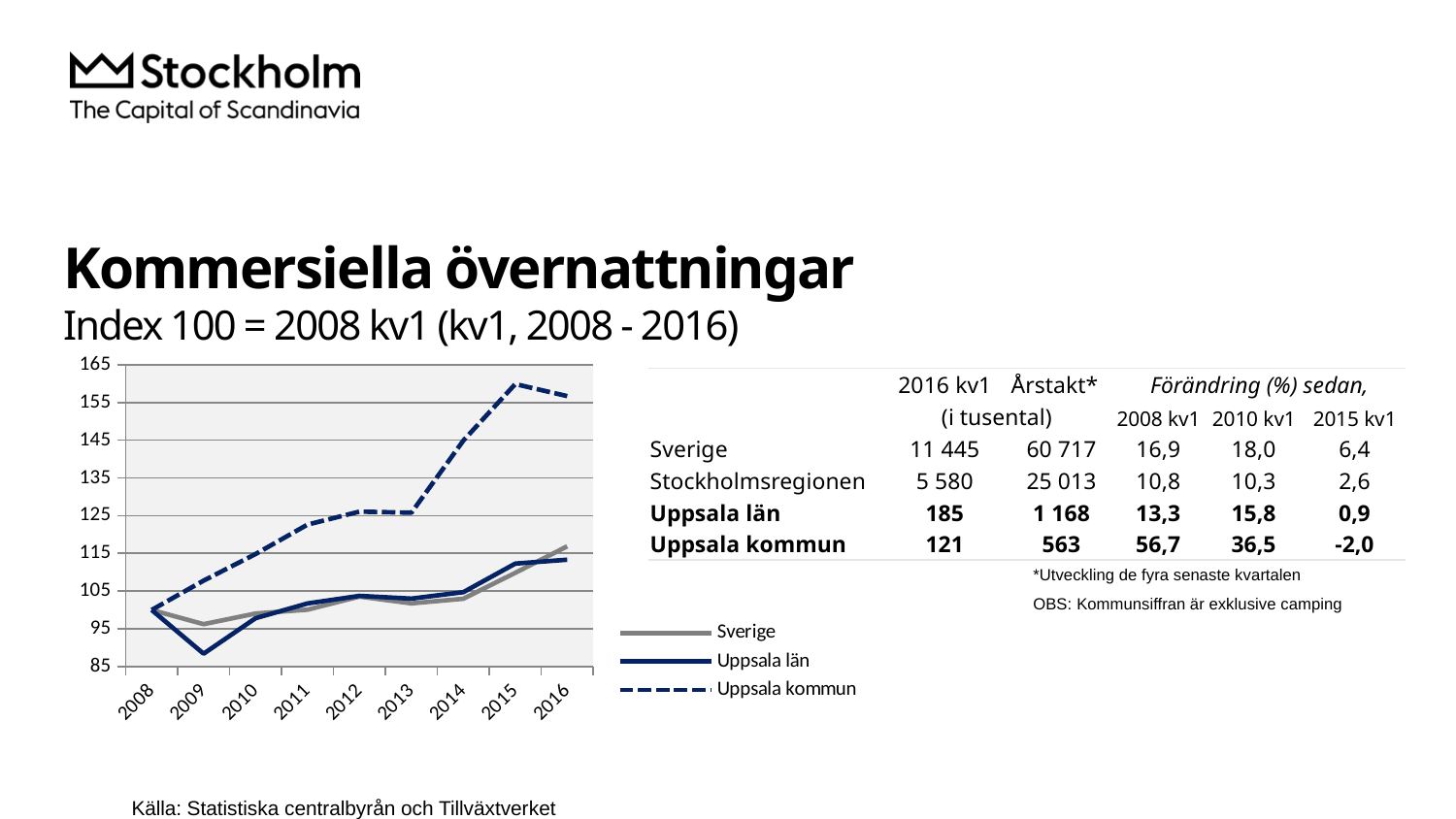
How many years are shown along the x axis of the chart? 9 Is the value for Uppsala län in 2009 greater or less than 95? less Is the value for Sverige in 2016 greater or less than 105? greater In 2014, which is larger: the value for Uppsala kommun or the value for Sverige? Uppsala kommun What kind of chart is shown on the slide? line chart Which series has the highest value in 2016? Uppsala kommun How many series does the chart legend list? 3 Is the value for Uppsala kommun in 2012 greater or less than 115? greater Which series is drawn with a dashed line in the chart? Uppsala kommun Does the Uppsala kommun series generally rise or fall from 2008 to 2016? rise Which series has the lowest value in 2009? Uppsala län